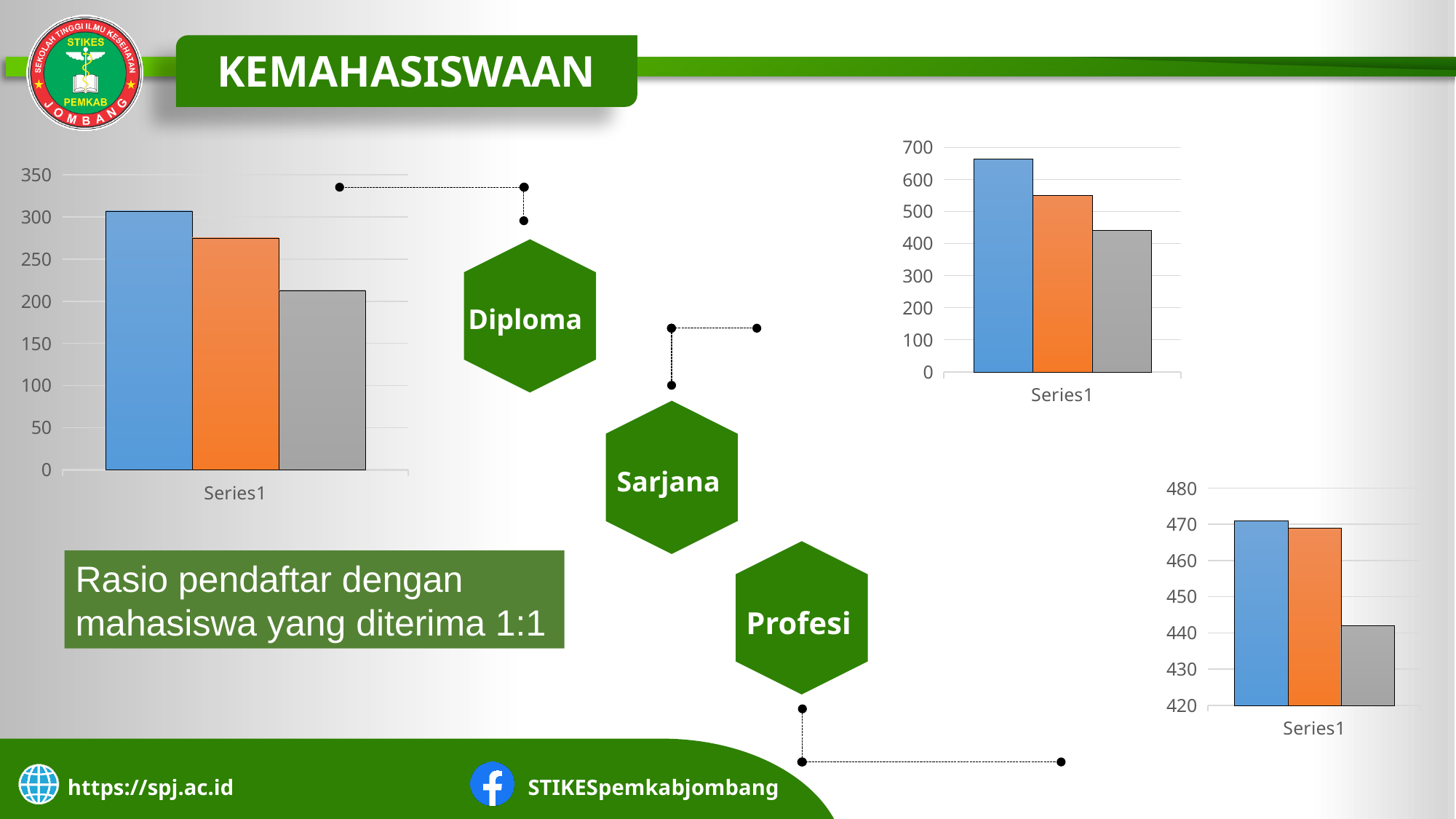
In the Sarjana chart at the top right, is the value of the blue bar greater or less than 600? greater In the Sarjana chart at the top right, is the value of the gray bar greater or less than 500? less How many bars are plotted in the Diploma chart on the left of the slide? 3 In the Diploma chart on the left, which bar is the lowest? the gray bar In the Sarjana chart at the top right, which bar is the highest? the blue bar In the Diploma chart on the left, is the value of the blue bar greater or less than 300? greater In the Sarjana chart at the top right, which is larger, the orange bar or the gray bar? the orange bar In the Profesi chart at the bottom right, which bar is the lowest? the gray bar What is the category label shown on the x axis of the Profesi chart at the bottom right? Series1 What kind of chart is the Diploma chart on the left of the slide? bar chart